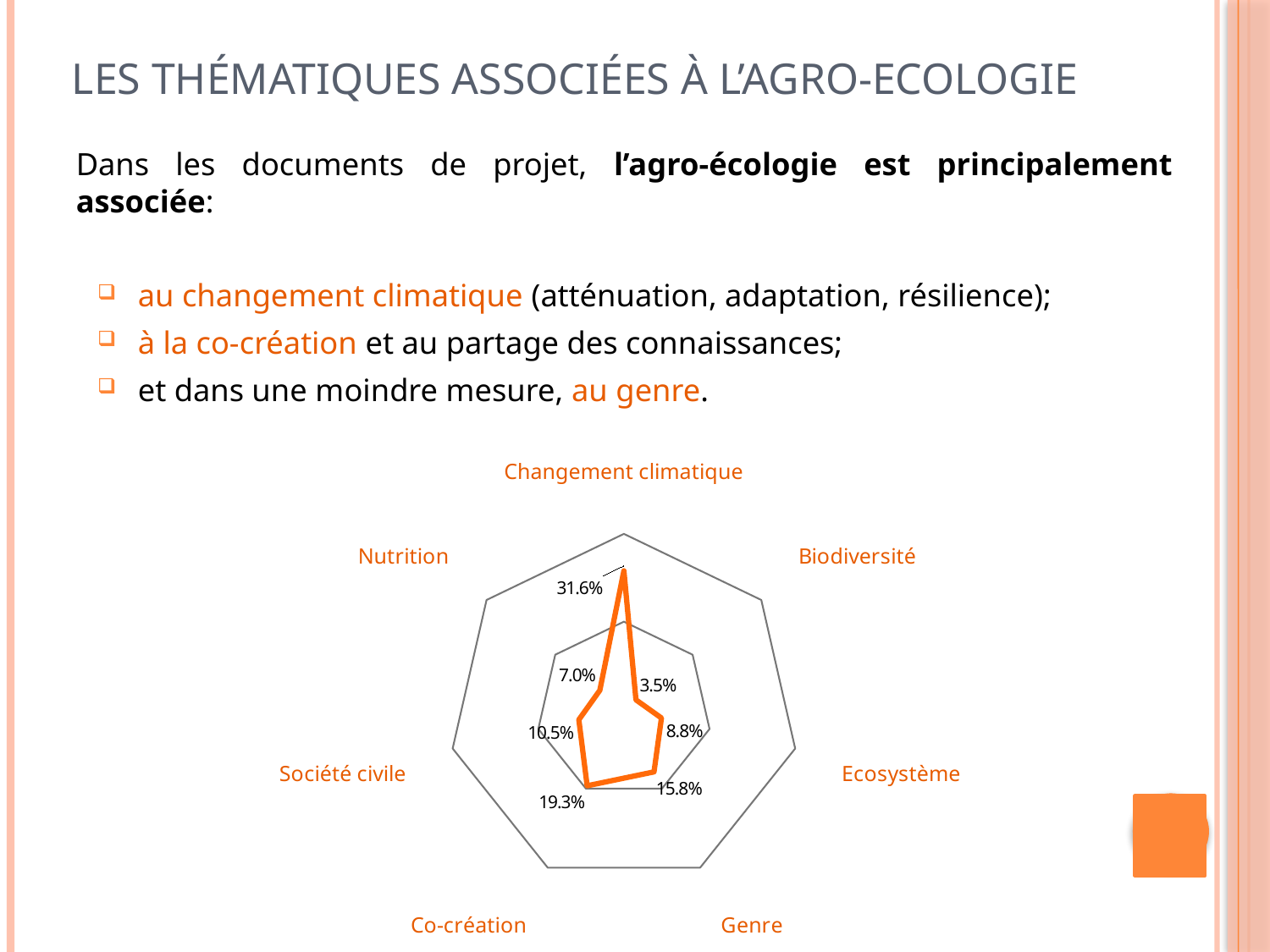
What is the value for Société civile? 10.5% What is the difference between the values for Co-création and Genre? 3.5% What is the value for Biodiversité? 3.5% How many categories does the chart have? 7 Which category has the lowest value? Biodiversité Which is larger, the value for Ecosystème or the value for Nutrition? Ecosystème What is the difference between the values for Changement climatique and Co-création? 12.3% What is the value for Co-création? 19.3% What kind of chart is shown on the slide? Radar chart What is the value for Genre? 15.8% Which category has the highest value? Changement climatique What is the value for Changement climatique? 31.6%